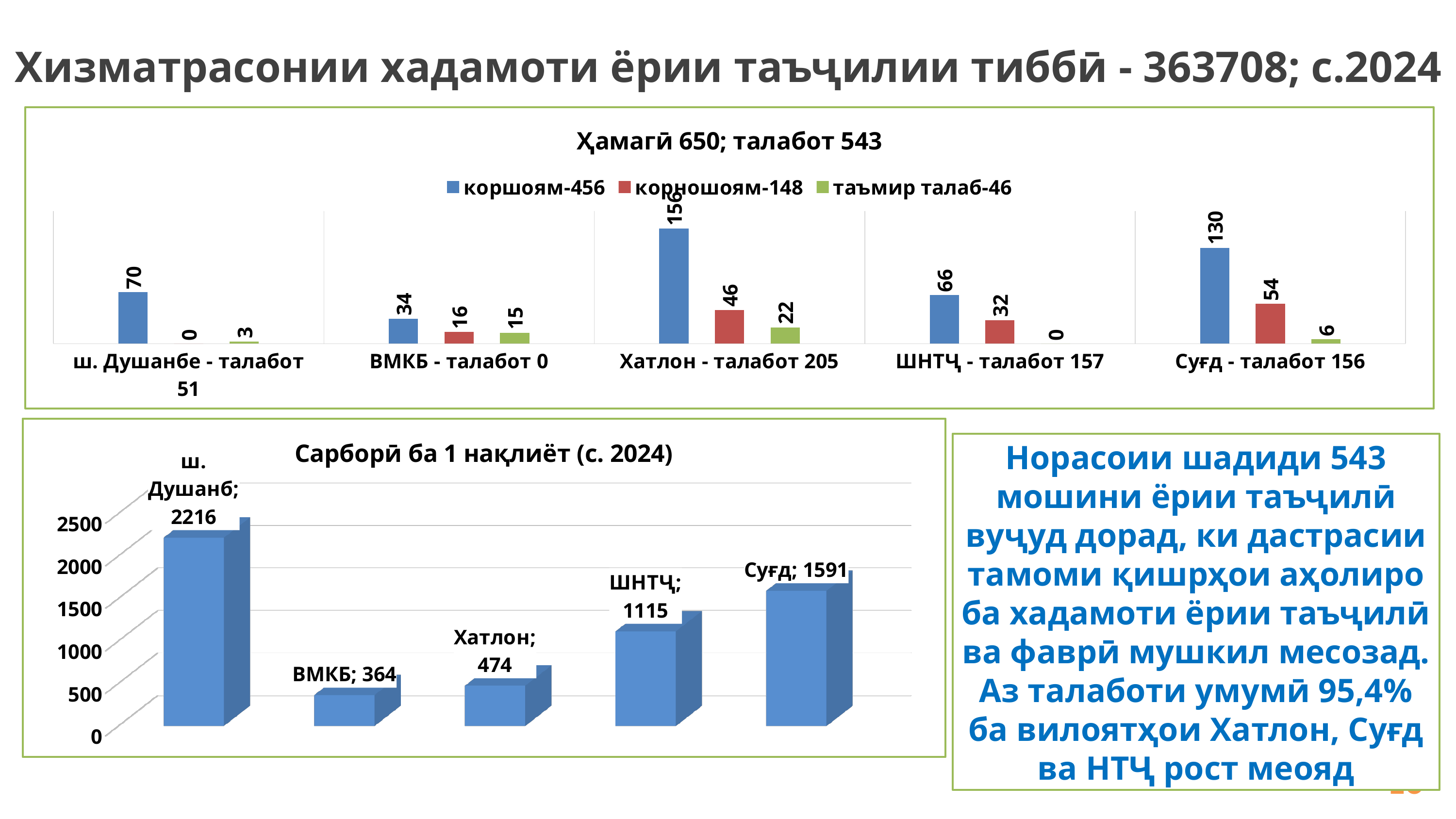
In the top chart 'Ҳамагӣ 650; талабот 543', what is the difference between the коршоям values for Суғд and ШНТҶ? 64 What kind of chart is the bottom chart 'Сарборӣ ба 1 нақлиёт (с. 2024)'? Bar chart In the bottom chart 'Сарборӣ ба 1 нақлиёт (с. 2024)', which is larger, the value for Суғд or the value for Хатлон? Суғд In the bottom chart 'Сарборӣ ба 1 нақлиёт (с. 2024)', how many regions are plotted? 5 In the top chart 'Ҳамагӣ 650; талабот 543', what is the value of коршоям for Хатлон? 156 In the bottom chart 'Сарборӣ ба 1 нақлиёт (с. 2024)', which region has the lowest value? ВМКБ In the top chart 'Ҳамагӣ 650; талабот 543', what is the total of the three values for Хатлон? 224 In the top chart 'Ҳамагӣ 650; талабот 543', which region has the highest коршоям value? Хатлон In the top chart 'Ҳамагӣ 650; талабот 543', how many series does the legend list? 3 In the top chart 'Ҳамагӣ 650; талабот 543', what is the value of таъмир талаб for ВМКБ? 15 In the bottom chart 'Сарборӣ ба 1 нақлиёт (с. 2024)', what is the value for ШНТҶ? 1115 In the top chart 'Ҳамагӣ 650; талабот 543', what is the value of корношоям for Суғд? 54